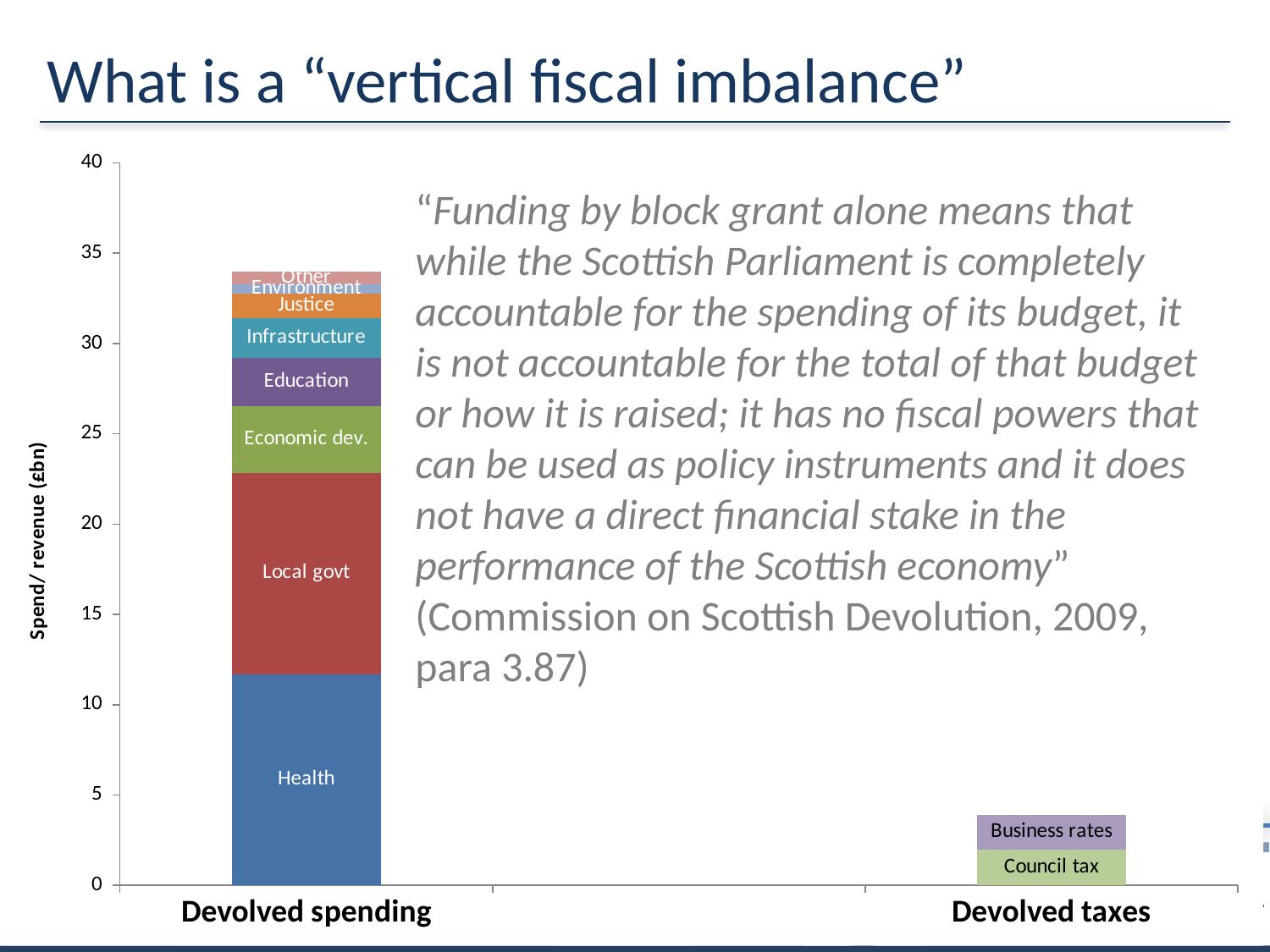
Which segment is larger in the Devolved spending bar, Local govt or Economic dev.? Local govt Which segment is the largest in the Devolved spending bar? Health Which segment is larger in the Devolved spending bar, Health or Education? Health What kind of chart is shown on the slide? stacked bar chart Which segment sits directly above Health in the Devolved spending bar? Local govt Which segment sits at the bottom of the Devolved taxes bar? Council tax How many categories are shown on the x axis of the chart? 2 What is the label on the y axis of the chart? Spend/ revenue (£bn) How many labelled segments make up the Devolved spending bar? 8 Is the total for Devolved spending greater or less than 30? greater Which category has the taller bar, Devolved spending or Devolved taxes? Devolved spending Is the total for Devolved taxes greater or less than 5? less